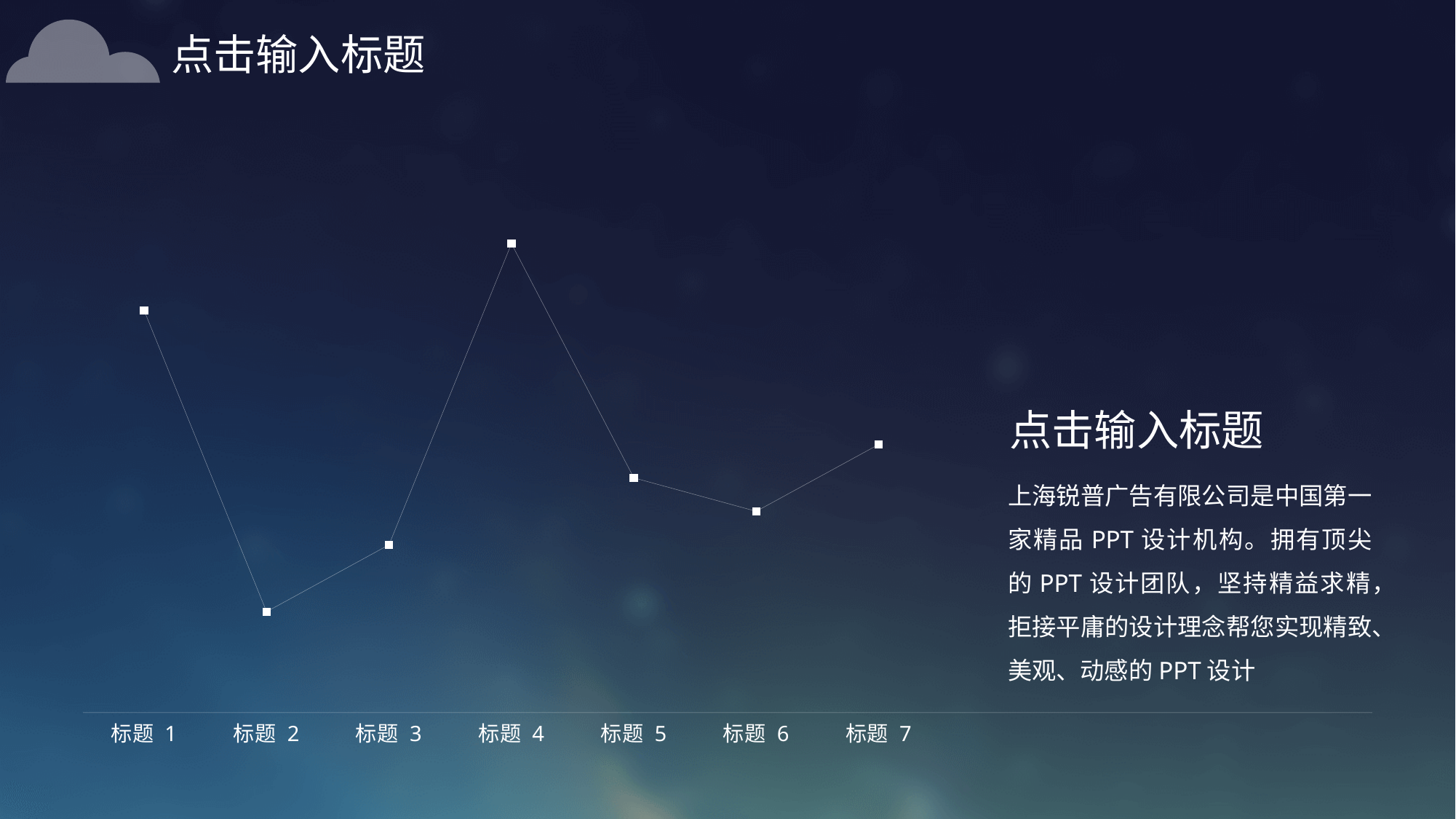
Which is larger, the value for 标题 5 or the value for 标题 6? 标题 5 Does the line rise or fall from 标题 4 to 标题 6? fall What is the label of the first category on the x axis of the line chart? 标题 1 Which is larger, the value for 标题 4 or the value for 标题 1? 标题 4 Which category has the highest value on the line chart? 标题 4 How many data points are plotted on the line chart? 7 Which is larger, the value for 标题 1 or the value for 标题 3? 标题 1 Does the line rise or fall from 标题 2 to 标题 4? rise Does the line rise or fall from 标题 1 to 标题 2? fall Which category has the lowest value on the line chart? 标题 2 What kind of chart is shown on the slide? line chart